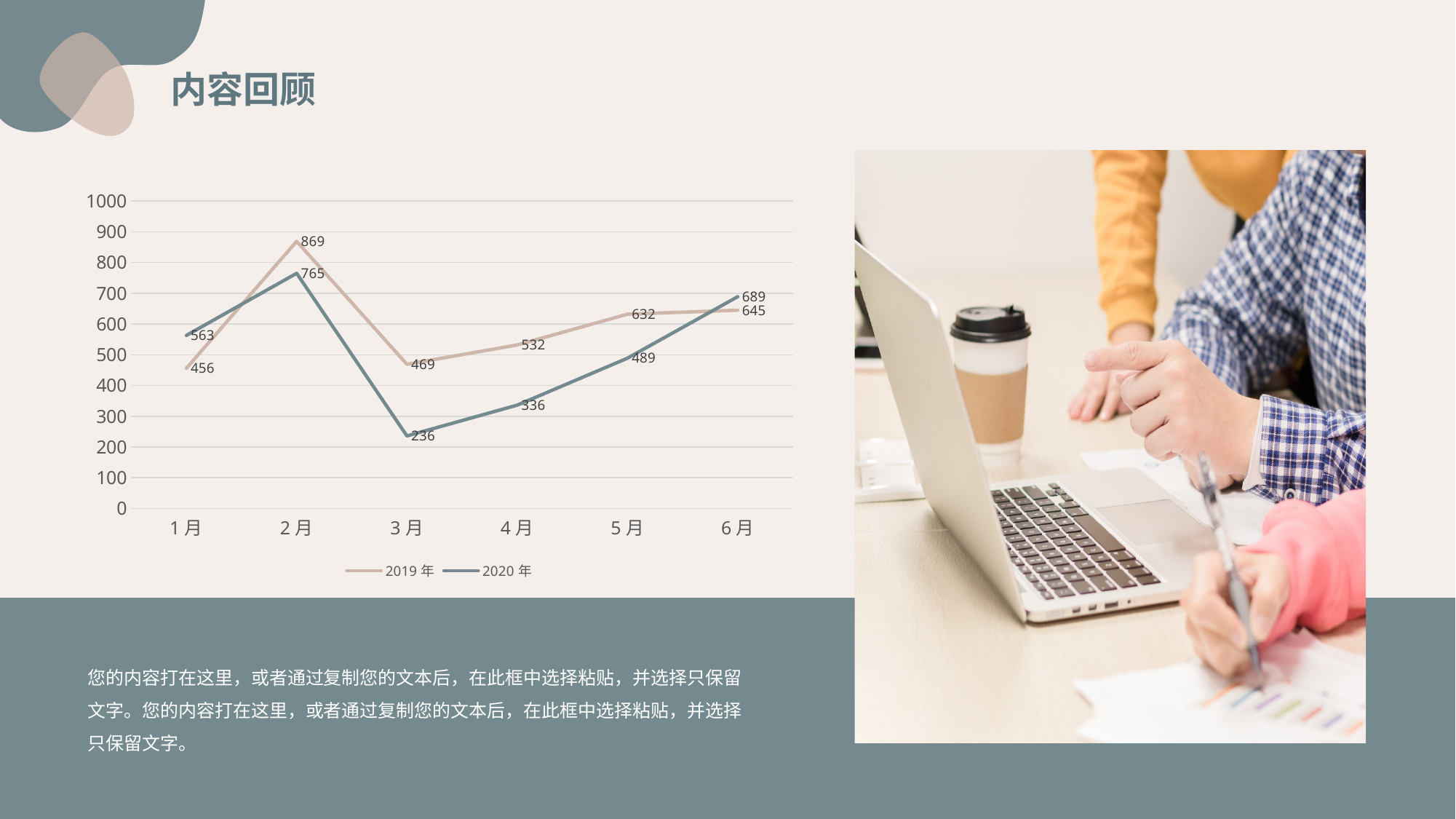
What is the value for 2020年 in 3月? 236 How many series does the legend list? 2 Which series has the larger value in 1月, 2019年 or 2020年? 2020年 Does the 2020年 series rise or fall from 3月 to 6月? rise How many months are shown on the x axis? 6 What is the difference between the 2019年 and 2020年 values in 2月? 104 Which month has the highest value for the 2019年 series? 2月 What is the title of the slide containing the chart? 内容回顾 Which month has the lowest value for the 2020年 series? 3月 What is the value for 2020年 in 6月? 689 What is the value for 2019年 in 2月? 869 What kind of chart is shown on the slide? line chart